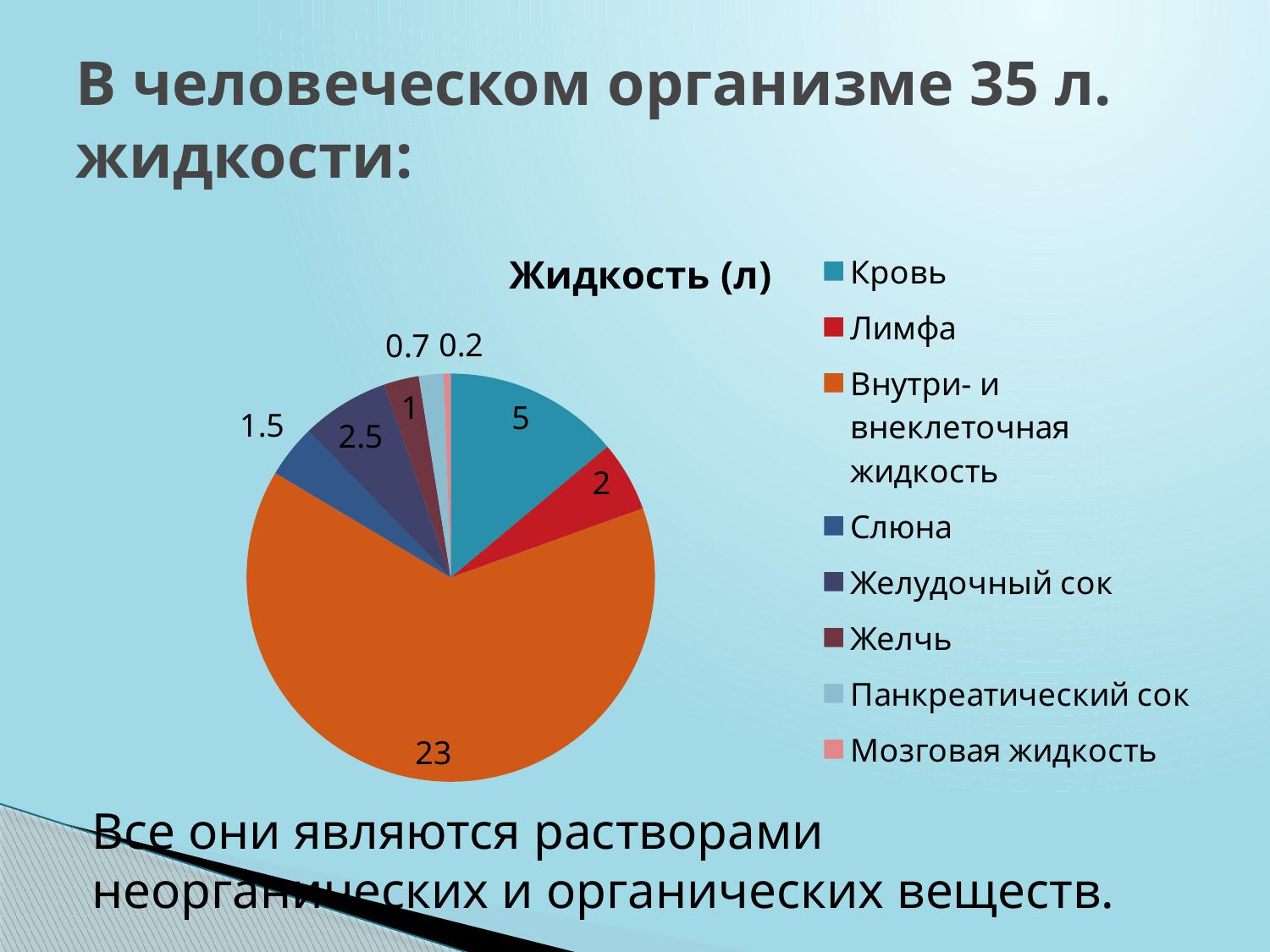
What is the value for Кровь? 5 How many categories does the legend of the pie chart list? 8 What is the value for Внутри- и внеклеточная жидкость? 23 What type of chart is shown on the slide? pie chart What is the difference between the values for Кровь and Лимфа? 3 Which is larger, the value for Слюна or the value for Желудочный сок? Желудочный сок Which category has the largest slice of the pie? Внутри- и внеклеточная жидкость What is the difference between the values for Желчь and Панкреатический сок? 0.3 What is the title of the chart? Жидкость (л) What is the value for Мозговая жидкость? 0.2 Which category has the smallest slice of the pie? Мозговая жидкость What is the value for Желудочный сок? 2.5